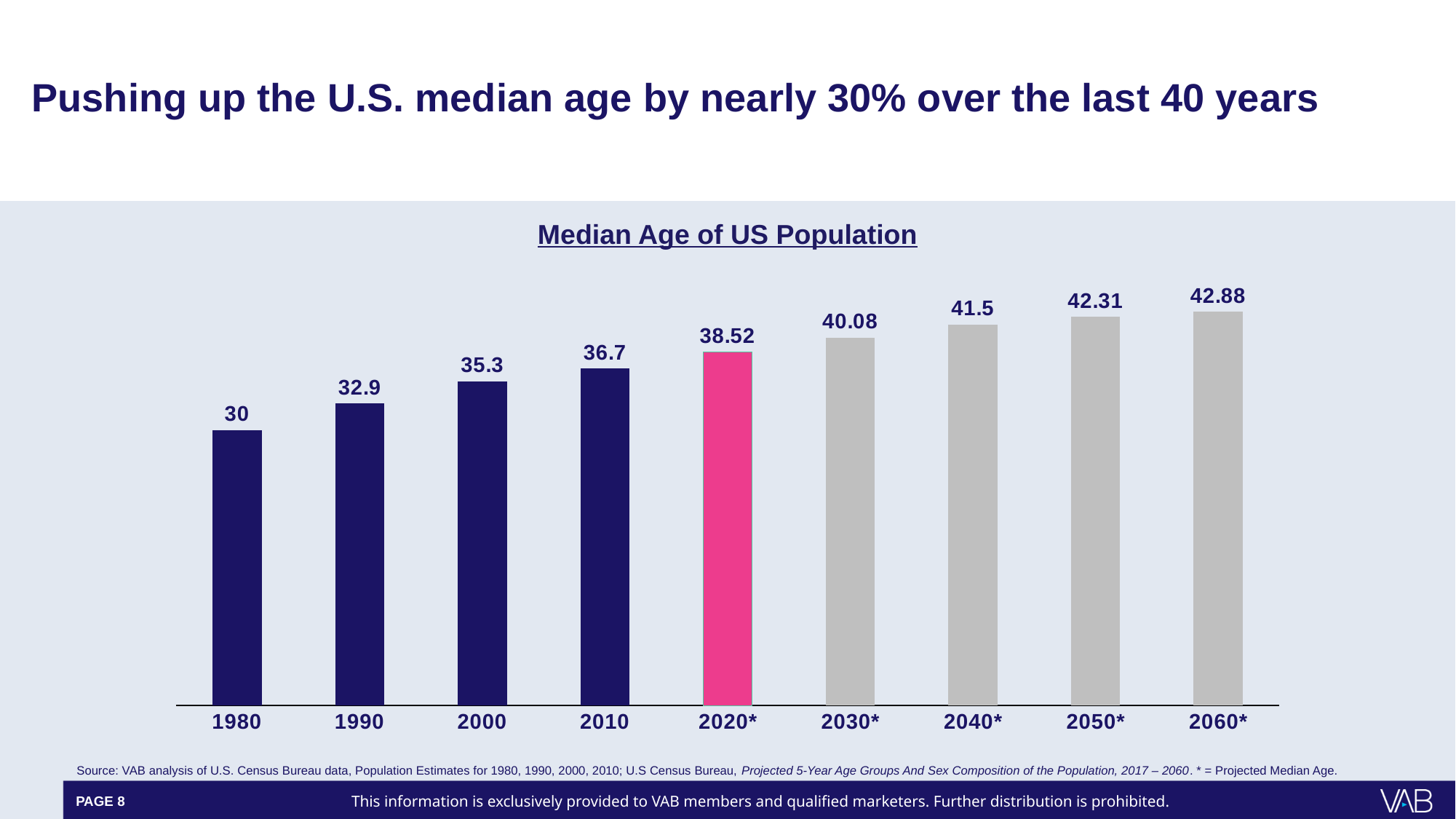
Which year has the highest median age on the chart? 2060* What value is shown for 2020*? 38.52 Do the median age values rise or fall from 1980 to 2060*? Rise What is the median age of the US population shown for 1980? 30 What is the title of the chart? Median Age of US Population Which is larger, the value for 2000 or the value for 1990? 2000 Which year has the lowest median age on the chart? 1980 How many years (bars) are shown on the chart? 9 What is the projected median age shown for 2060*? 42.88 What kind of chart is shown on the slide? Bar chart What is the difference between the median age in 2010 and in 1980? 6.7 What is the difference between the values for 2030* and 2020*? 1.56